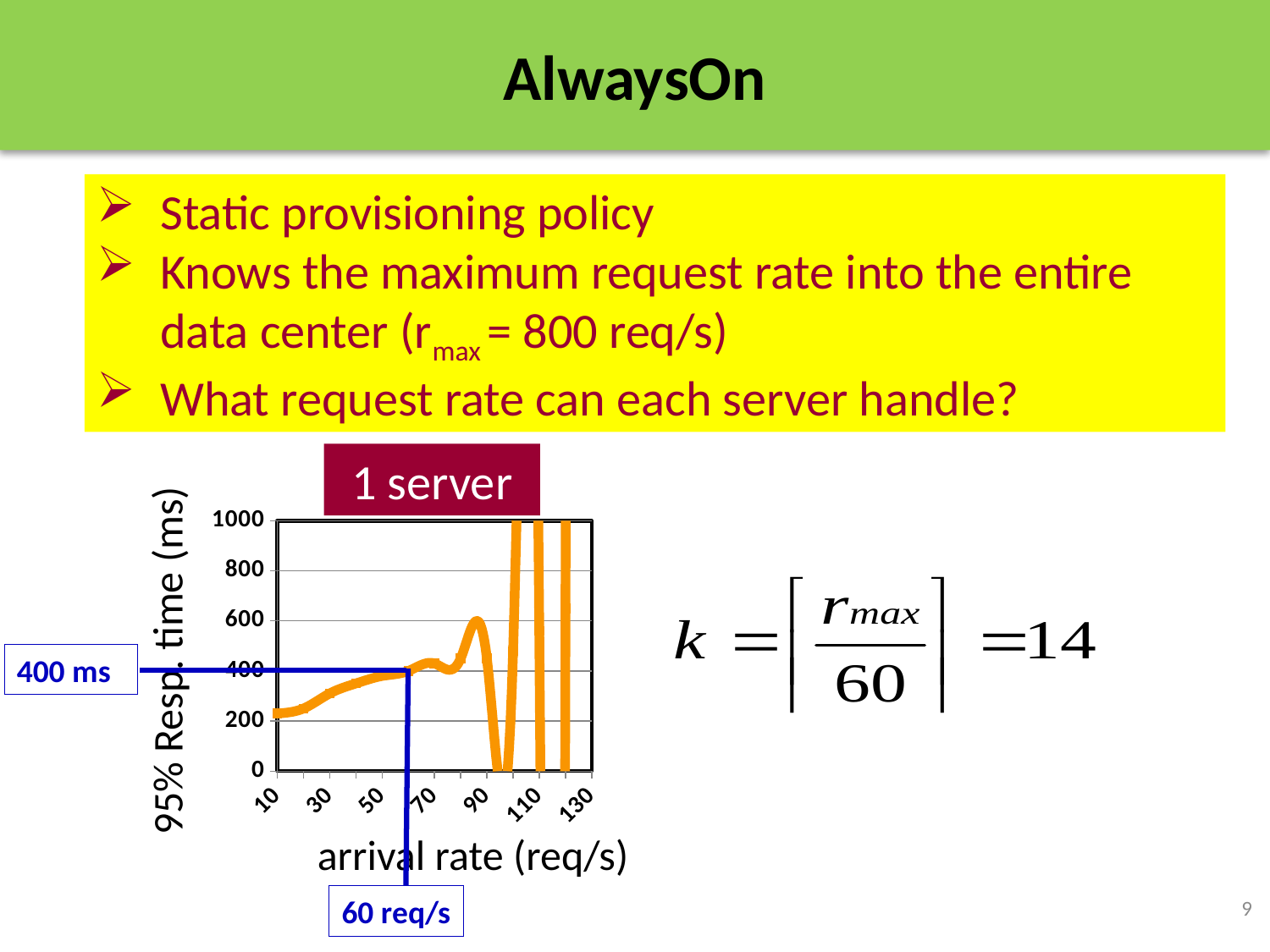
Is the 95% response time at an arrival rate of 10 req/s greater or less than 400? less What kind of chart is shown under the '1 server' label? line chart According to the annotation on the chart, what is the 95% response time at an arrival rate of 60 req/s? 400 ms What is the highest value shown on the chart's y axis? 1000 According to the annotation on the chart, at what arrival rate does the 95% response time reach 400 ms? 60 req/s What is the lowest tick label on the chart's x axis? 10 What is the label of the chart's y axis? 95% Resp. time (ms) What is the title shown above the chart? 1 server Does the 95% response time rise or fall as the arrival rate increases from 10 to 60 req/s? rise How many tick labels are shown on the chart's x axis? 7 Is the 95% response time at an arrival rate of 30 req/s greater or less than 600? less